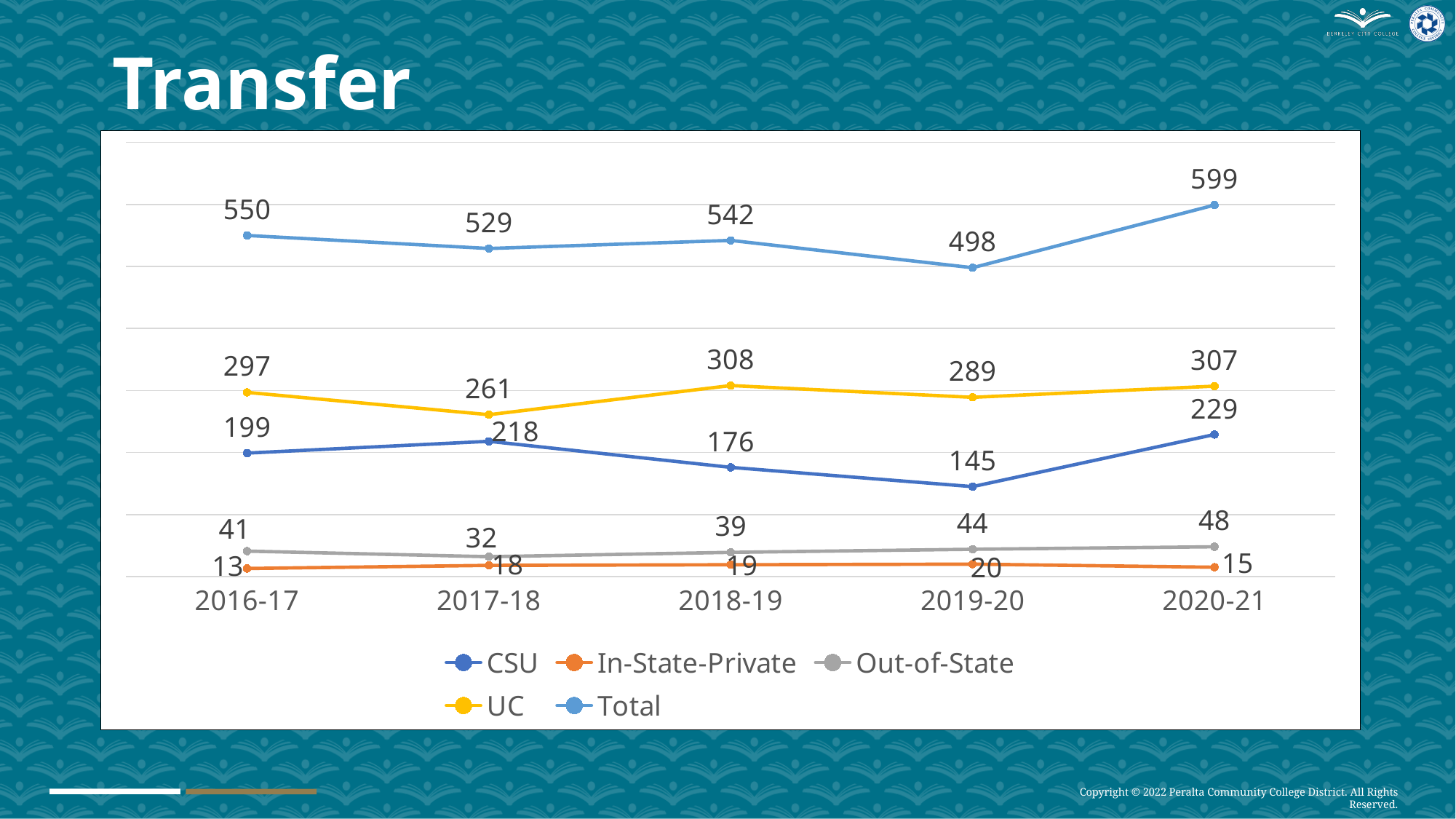
What is the difference between the Total values for 2020-21 and 2019-20? 101 In which year is the UC series highest? 2018-19 What is the UC value for 2017-18? 261 What kind of chart is shown on the slide? line chart How many years are shown on the x axis? 5 Does the Out-of-State series rise or fall from 2017-18 to 2020-21? rise What is the CSU value for 2019-20? 145 In which year is the Total series lowest? 2019-20 How many series does the legend list? 5 What is the In-State-Private value for 2016-17? 13 Which is larger, the CSU value for 2017-18 or the CSU value for 2018-19? 2017-18 What is the Total value for 2020-21? 599